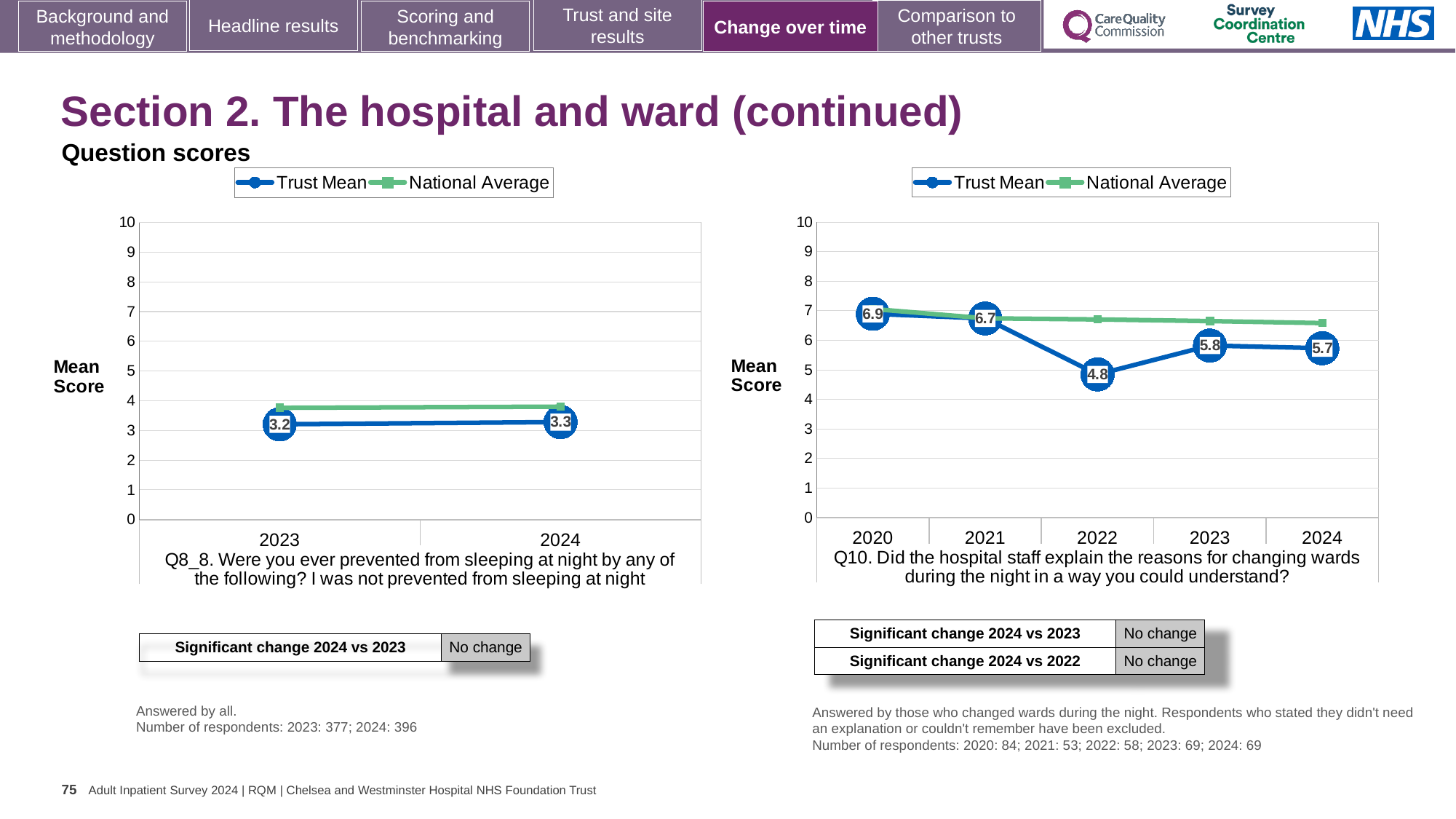
In the left chart (Q8_8), is the National Average value for 2024 greater or less than 3? greater In the right chart (Q10), which year has the lowest Trust Mean score? 2022 How many years are plotted on the x axis of the right chart (Q10)? 5 What kind of chart is the right chart (Q10)? Line chart In the right chart (Q10), is the Trust Mean for 2021 or 2023 larger? 2021 In the right chart (Q10), what is the Trust Mean score for 2024? 5.7 In the right chart (Q10), what is the Trust Mean score for 2022? 4.8 In the left chart (Q8_8), what is the Trust Mean score for 2024? 3.3 How many series does the legend of the left chart (Q8_8) list? 2 In the right chart (Q10), what is the difference between the Trust Mean scores for 2020 and 2022? 2.1 In the left chart (Q8_8), what is the Trust Mean score for 2023? 3.2 In the right chart (Q10), which year has the highest Trust Mean score? 2020